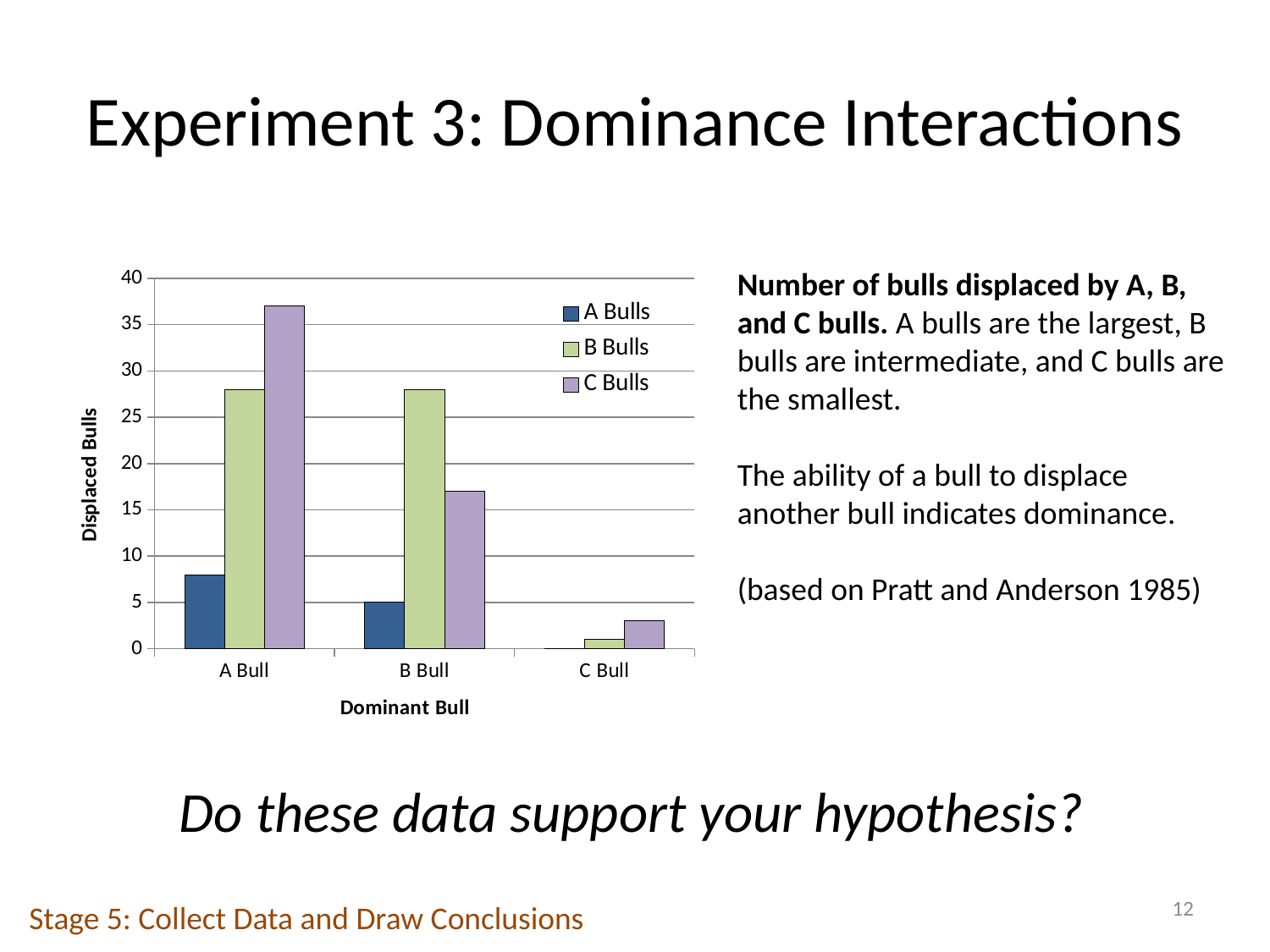
Is the A Bulls value for the A Bull category greater or less than 10? less What is the title of the y axis? Displaced Bulls For the B Bull category, which series has the tallest bar? B Bulls Is the C Bulls value for the A Bull category greater or less than 35? greater What kind of chart is shown on the slide? bar chart Which dominant bull category has the lowest bars overall? C Bull Is the C Bulls value for the B Bull category greater or less than 15? greater How many dominant bull categories are shown on the x axis? 3 For the A Bull category, which series has the tallest bar? C Bulls Do the C Bulls values rise or fall moving from A Bull to C Bull along the x axis? fall How many series does the chart legend list? 3 Which is larger: the C Bulls value for A Bull or the C Bulls value for B Bull? A Bull